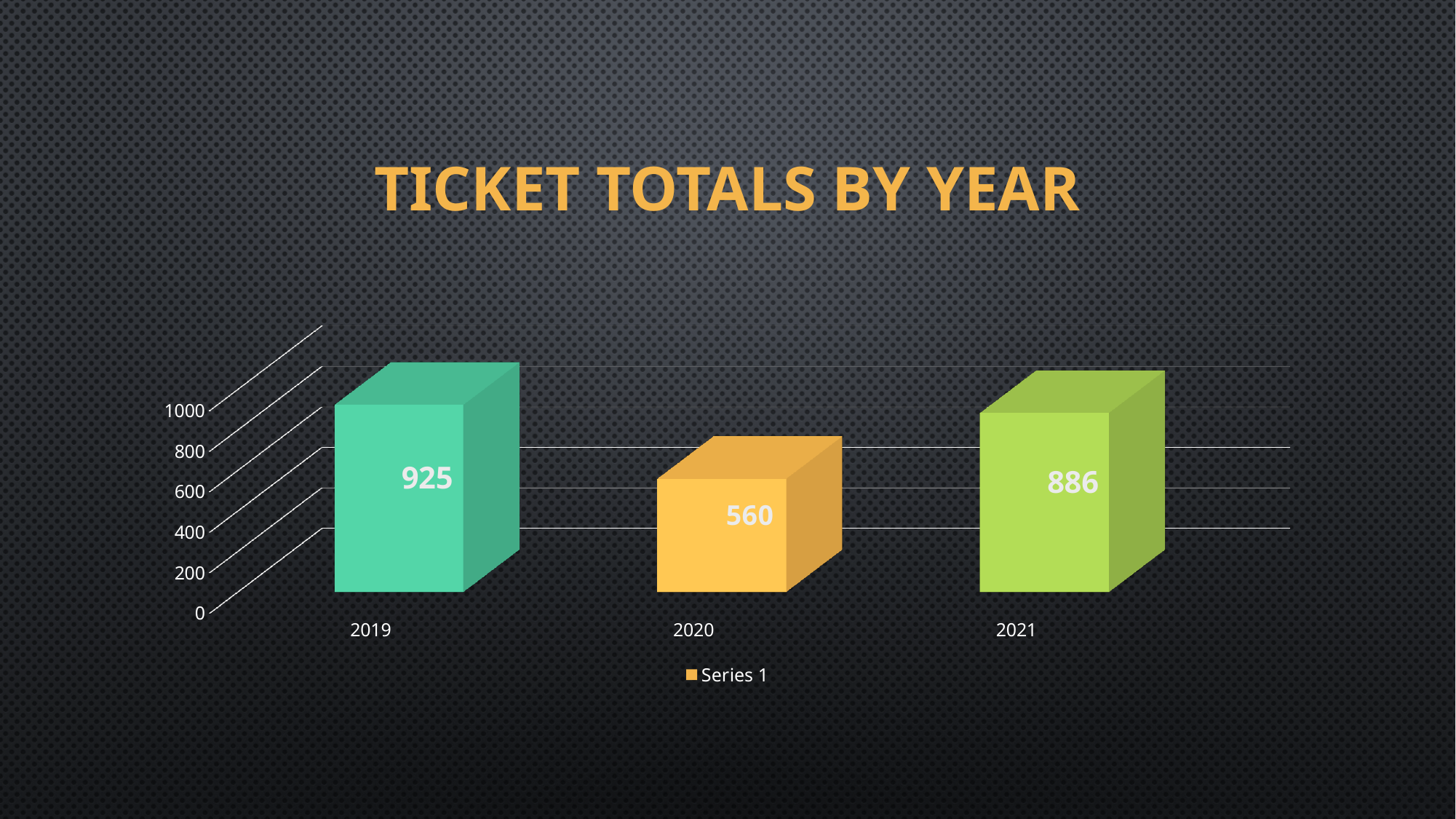
How many years are shown on the chart? 3 Is the ticket total for 2020 greater or less than 600? less What is the ticket total for 2019? 925 What is the difference between the ticket totals for 2021 and 2020? 326 What is the difference between the ticket totals for 2019 and 2020? 365 What is the ticket total for 2020? 560 Which year has the highest ticket total? 2019 What is the ticket total for 2021? 886 What kind of chart is shown on the slide? bar chart Which year has a larger ticket total, 2020 or 2021? 2021 What is the title of the chart? Ticket Totals by Year Which year has the lowest ticket total? 2020